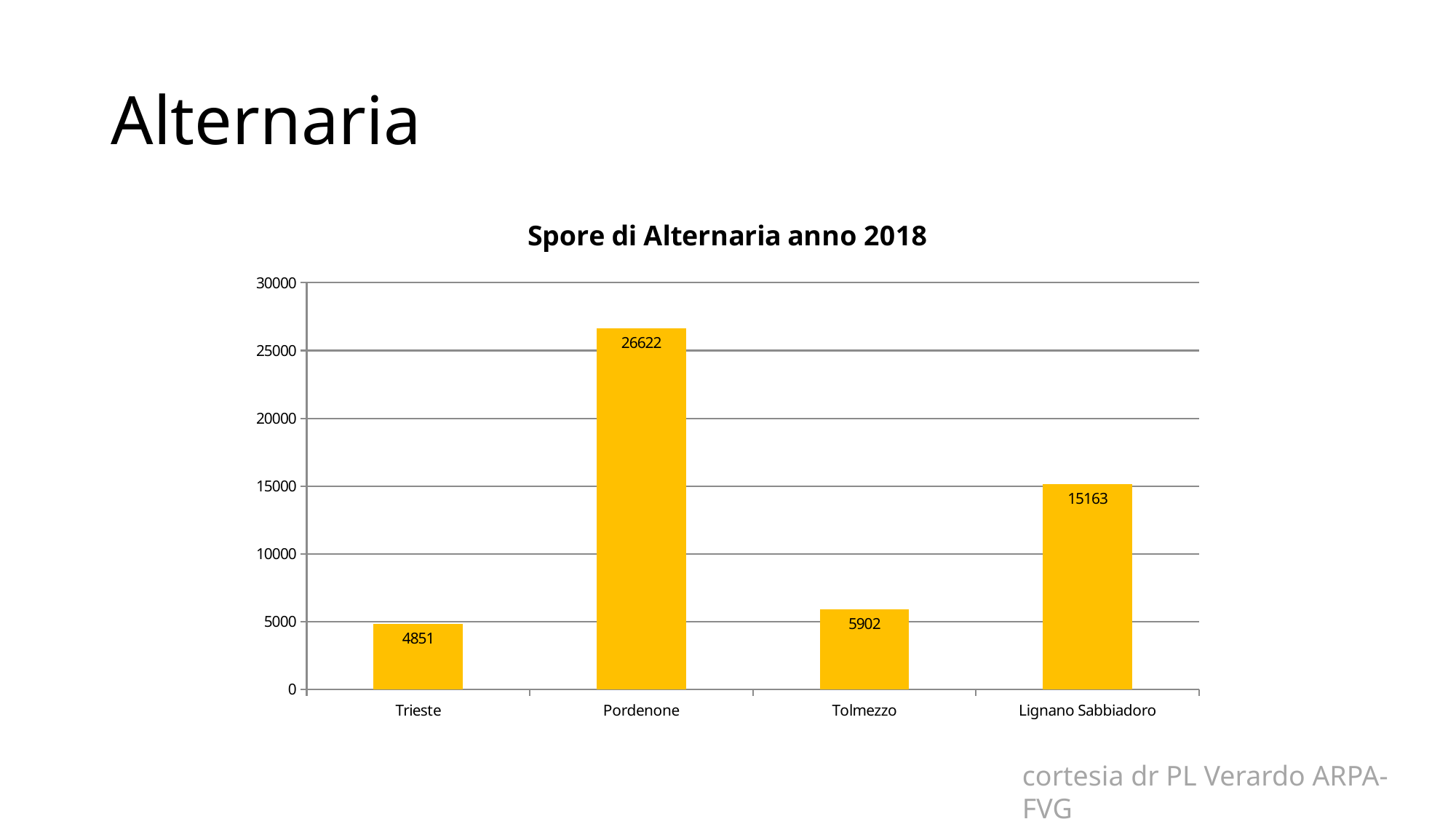
What is the value for Lignano Sabbiadoro? 15163 What is the value for Trieste? 4851 Which is larger, the value for Lignano Sabbiadoro or the value for Tolmezzo? Lignano Sabbiadoro Which location has the highest value? Pordenone What is the difference between the values for Pordenone and Lignano Sabbiadoro? 11459 What is the value for Tolmezzo? 5902 Which location has the lowest value? Trieste What is the difference between the values for Tolmezzo and Trieste? 1051 What type of chart is shown? bar chart How many locations are shown on the chart? 4 What is the value for Pordenone? 26622 Is the value for Pordenone greater or less than 25000? greater